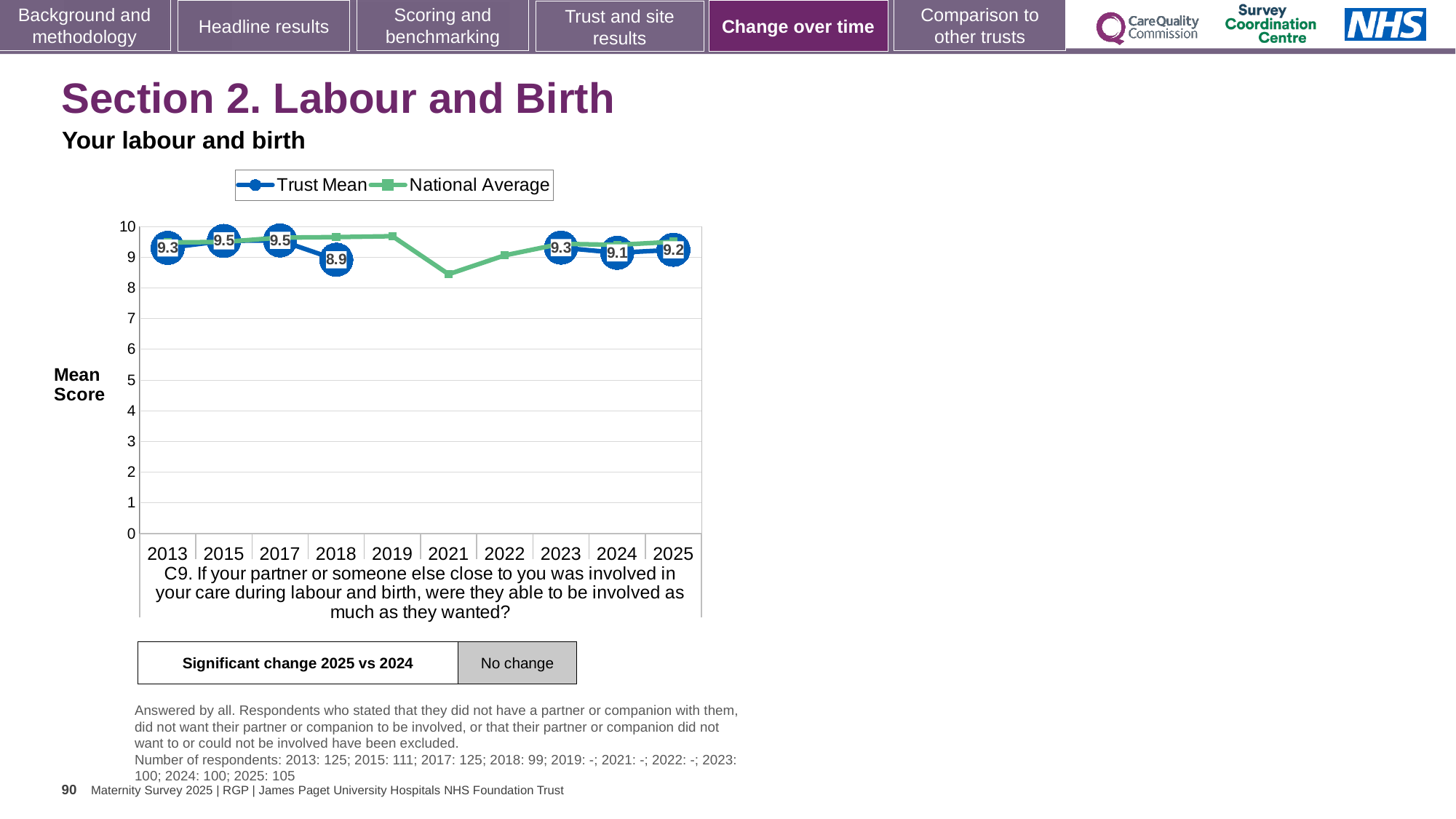
What kind of chart is shown on the slide? line chart What is the difference between the Trust Mean scores for 2025 and 2024? 0.1 What is the Trust Mean score for 2025? 9.2 In which year is the Trust Mean score lowest? 2018 What is the Trust Mean score for 2013? 9.3 What is the difference between the Trust Mean scores for 2017 and 2018? 0.6 Which year has the higher Trust Mean score, 2015 or 2024? 2015 What is the Trust Mean score for 2018? 8.9 Is the National Average value for 2021 greater or less than 9? less What is the highest Trust Mean score shown on the chart? 9.5 How many years are shown on the x axis of the chart? 10 How many series does the chart legend list? 2